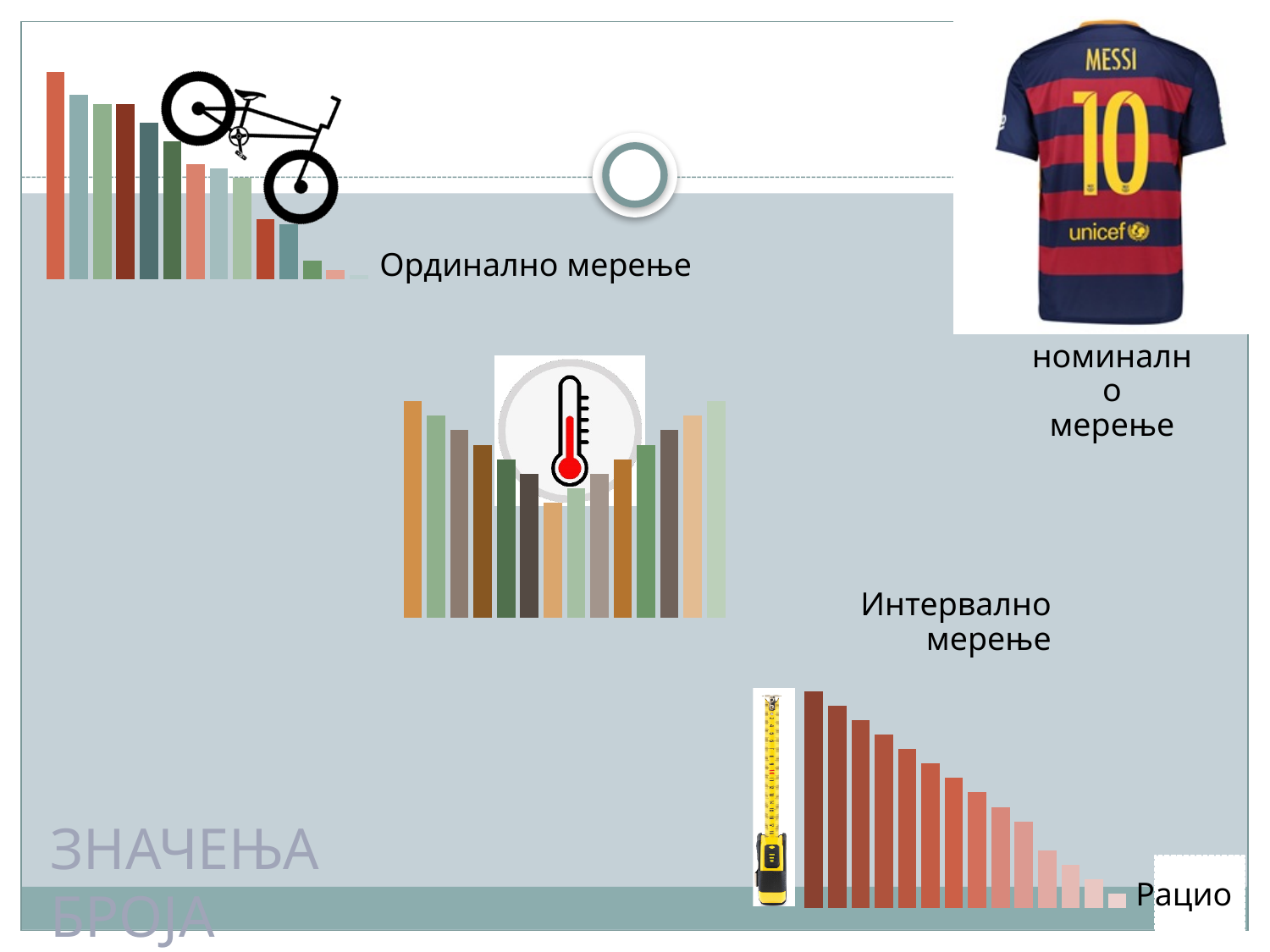
In the chart at the top left of the slide, do the bar heights rise or fall from left to right? fall What label is written next to the chart at the bottom right of the slide? Рацио In the chart in the middle of the slide, which bar is taller, the leftmost bar or the bar immediately to its right? the leftmost In the chart at the bottom right of the slide, which bar is taller, the leftmost or the rightmost? the leftmost What kind of chart is shown at the top left of the slide, next to the bicycle? bar chart In the chart at the bottom right of the slide, do the bar heights rise or fall from left to right? fall What kind of chart is shown in the middle of the slide, behind the thermometer icon? bar chart What label is written to the right of the chart at the top left of the slide? Ординално мерење What kind of chart is shown at the bottom right of the slide, next to the tape measure? bar chart